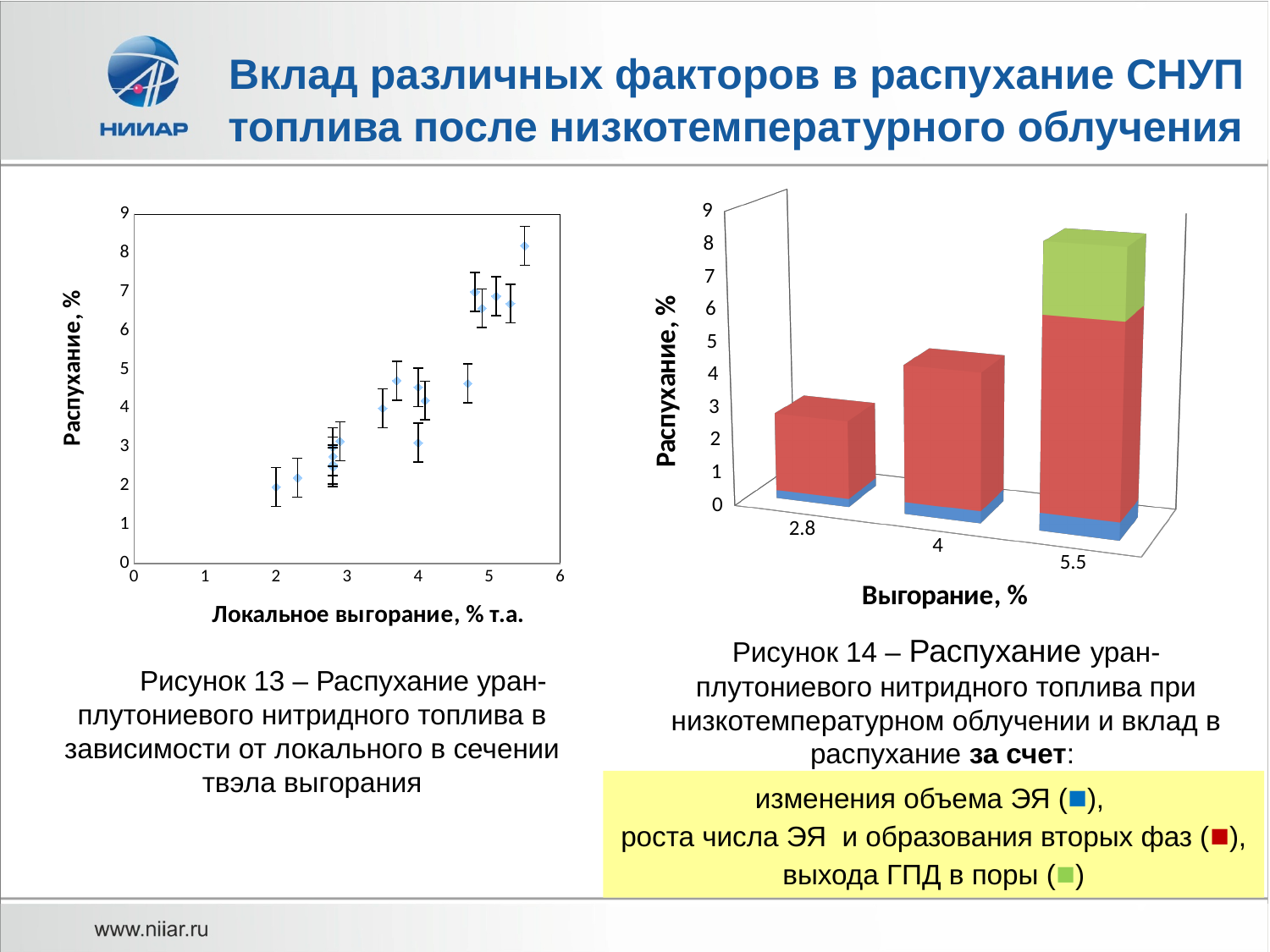
In the right chart (Рисунок 14), is the total height of the bar for burnup 5.5 greater or less than 6? greater In the right chart (Рисунок 14), which burnup category has the tallest stacked bar? 5.5 In the right chart (Рисунок 14), which burnup category is the only one with a green segment? 5.5 In the left chart (Рисунок 13), what is the title of the x axis? Локальное выгорание, % т.а. In the left chart (Рисунок 13), is the swelling value of the point at burnup 2 % т.а. greater or less than 3? less In the right chart (Рисунок 14), how many burnup categories are shown on the x axis? 3 In the left chart (Рисунок 13), do the swelling values rise or fall as local burnup increases along the x axis? rise What kind of chart is the left chart (Рисунок 13)? scatter chart What kind of chart is the right chart (Рисунок 14)? bar chart In the right chart (Рисунок 14), is the total height of the bar for burnup 2.8 greater or less than 4? less In the right chart (Рисунок 14), which burnup category has the shortest stacked bar? 2.8